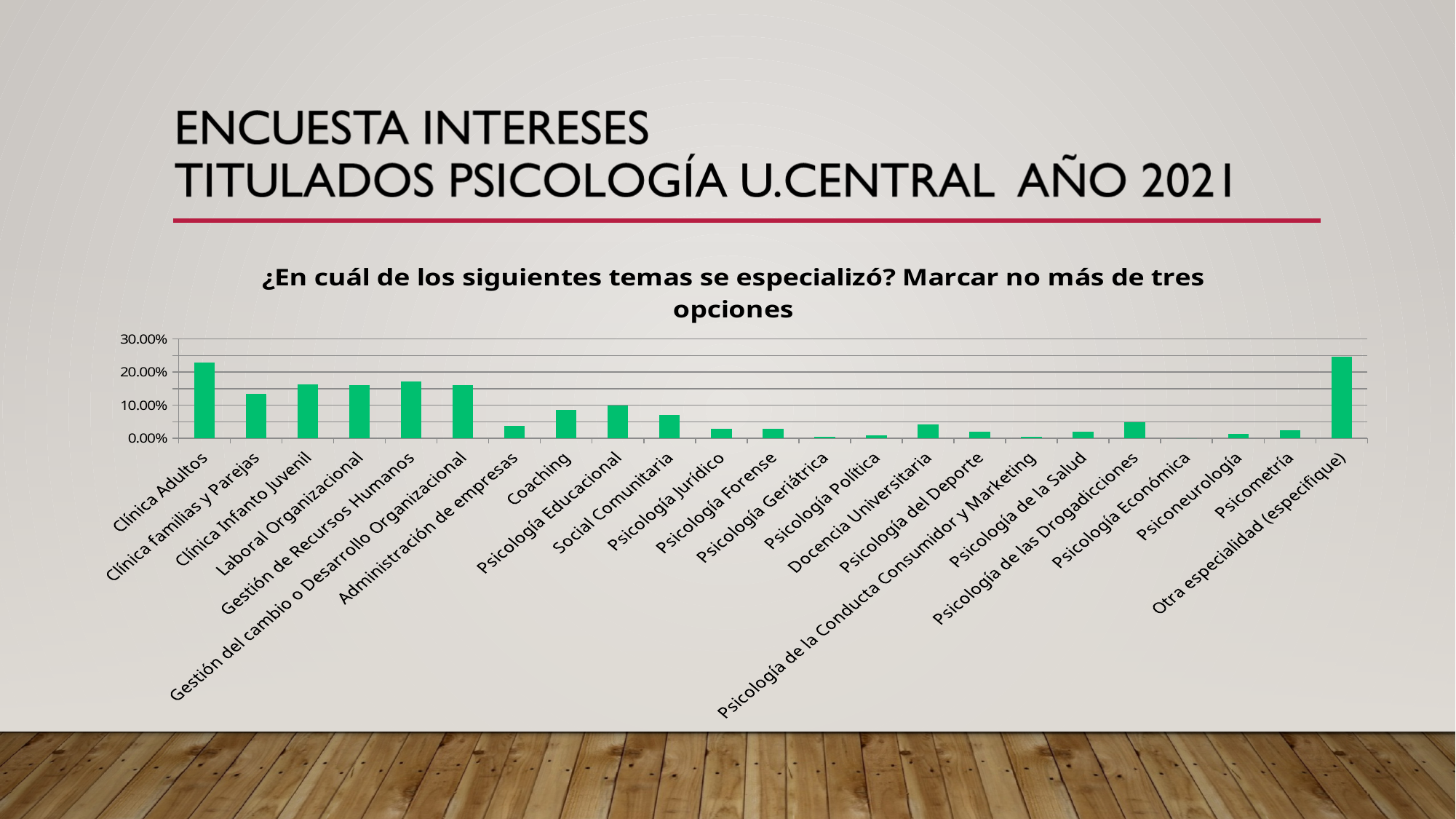
Is the value for Psicología de las Drogadicciones greater or less than 10.00%? less What kind of chart is shown on the slide? Bar chart How many categories are shown on the x axis of the chart? 23 Is the value for Gestión de Recursos Humanos greater or less than 20.00%? less Is the value for Clínica Adultos greater or less than 20.00%? greater Which has a higher value, Docencia Universitaria or Psicología Política? Docencia Universitaria Which has a higher value, Clínica Adultos or Coaching? Clínica Adultos What colour are the bars in the chart? Green Which has a higher value, Gestión de Recursos Humanos or Clínica familias y Parejas? Gestión de Recursos Humanos